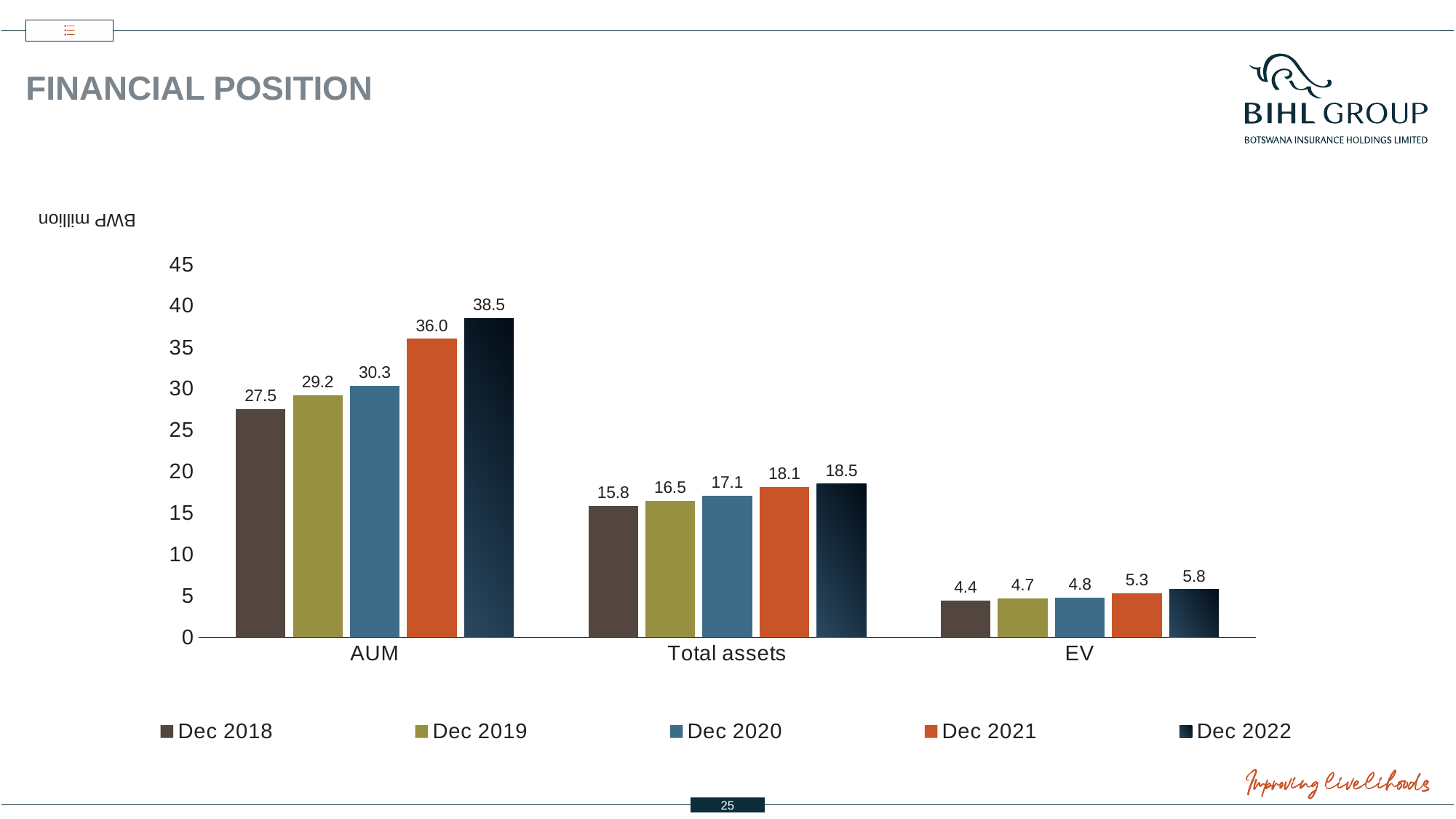
What kind of chart is shown on the slide? Bar chart Which is larger, the AUM value for Dec 2021 or the AUM value for Dec 2020? Dec 2021 What is the difference between the AUM values for Dec 2022 and Dec 2018? 11.0 How many series does the legend list? 5 Which year has the lowest EV value? Dec 2018 Which year has the highest AUM value? Dec 2022 What is the AUM value for Dec 2022? 38.5 Do the Total assets values rise or fall from Dec 2018 to Dec 2022? Rise What is the difference between the Total assets values for Dec 2021 and Dec 2020? 1.0 What is the EV value for Dec 2021? 5.3 How many categories are shown on the x axis? 3 What is the Total assets value for Dec 2018? 15.8